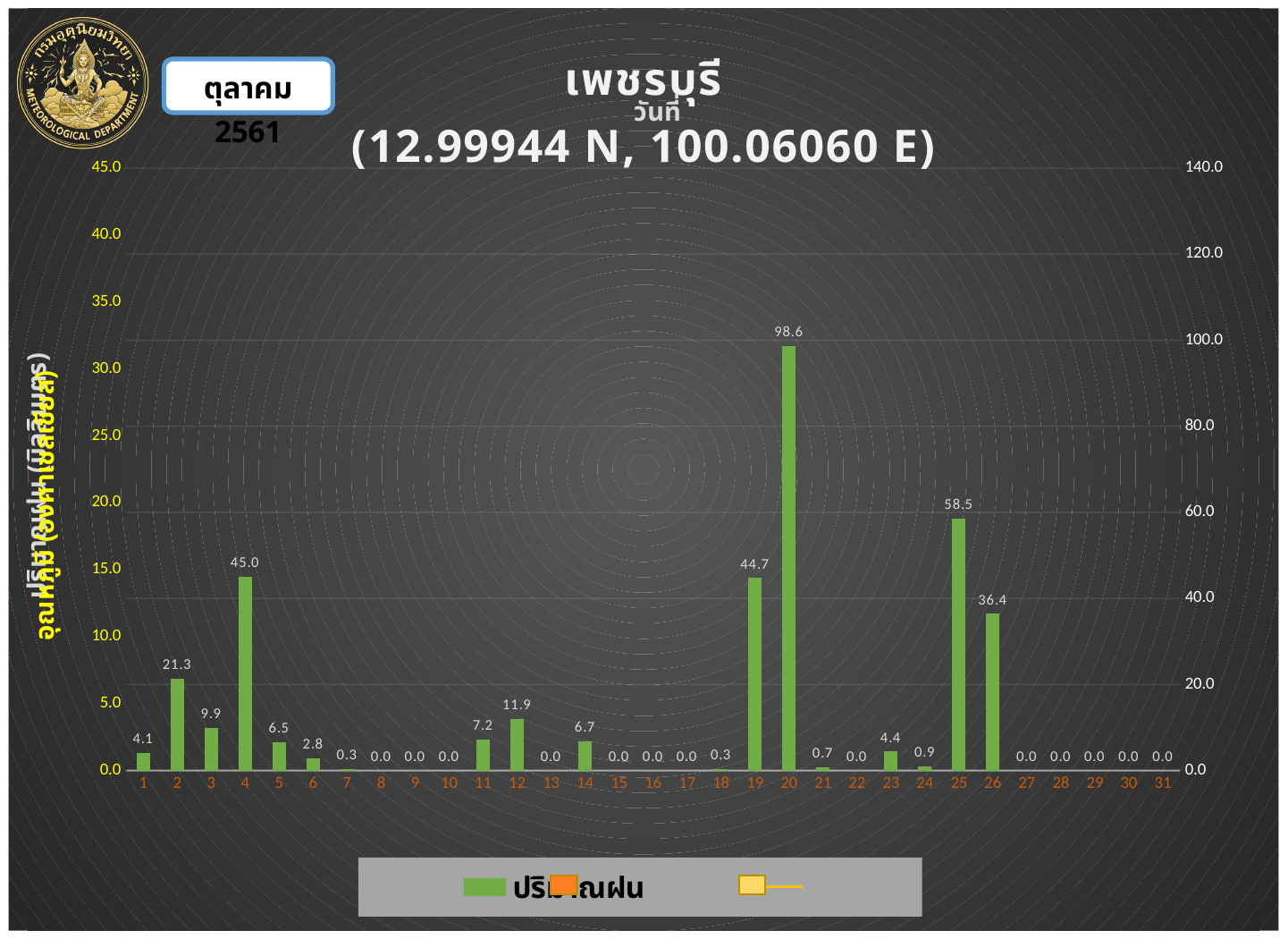
How many days are shown on the x axis? 31 Which day has the highest rainfall value? 20 What is the rainfall value shown for day 25? 58.5 What is the rainfall value shown for day 4? 45.0 What is the difference between the rainfall values for day 4 and day 19? 0.3 What is the rainfall value shown for day 12? 11.9 What coordinates are given in the chart title? 12.99944 N, 100.06060 E What is the rainfall value shown for day 20? 98.6 What kind of chart is used to show the rainfall values? bar chart What is the difference between the rainfall values for day 20 and day 25? 40.1 Is the rainfall value for day 20 greater or less than 80.0 on the right axis? greater Which is larger, the rainfall value for day 2 or for day 26? day 26